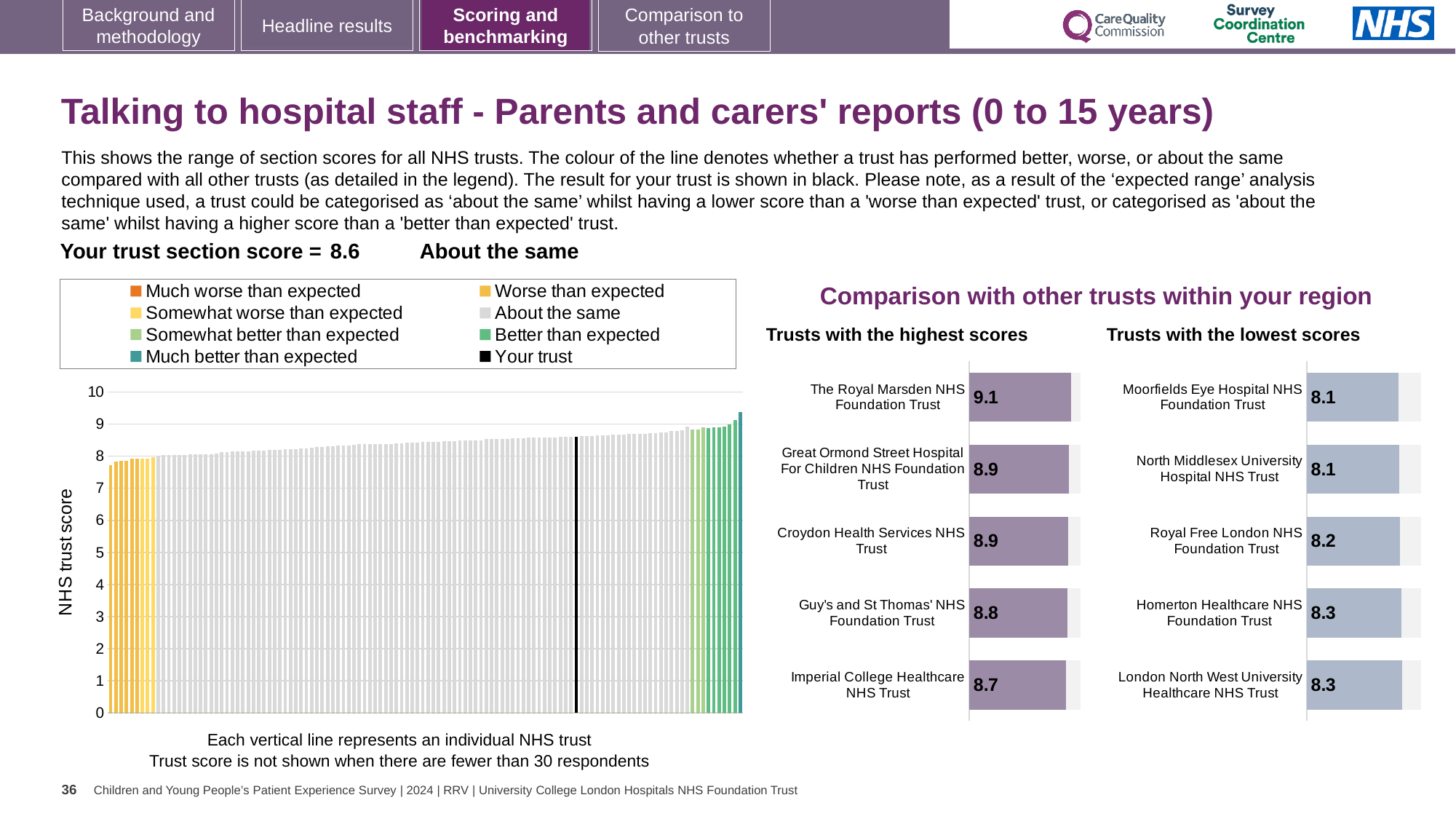
In the 'Trusts with the highest scores' chart, which has the higher score: Croydon Health Services NHS Trust or Guy's and St Thomas' NHS Foundation Trust? Croydon Health Services NHS Trust How many trusts are shown in the 'Trusts with the lowest scores' chart? 5 What kind of chart is the main 'NHS trust score' chart on the left? Bar chart In the 'Trusts with the highest scores' chart, what is the difference between the scores of The Royal Marsden NHS Foundation Trust and Imperial College Healthcare NHS Trust? 0.4 In the 'Trusts with the lowest scores' chart, what is the difference between the scores of Royal Free London NHS Foundation Trust and Moorfields Eye Hospital NHS Foundation Trust? 0.1 In the 'Trusts with the highest scores' chart, which trust has the highest score? The Royal Marsden NHS Foundation Trust In the main 'NHS trust score' chart on the left, what is the section score for your trust? 8.6 In the 'Trusts with the highest scores' chart, what is the score for Imperial College Healthcare NHS Trust? 8.7 How many entries does the legend of the main 'NHS trust score' chart on the left list? 8 In the 'Trusts with the lowest scores' chart, what is the score for Homerton Healthcare NHS Foundation Trust? 8.3 What is the title of the section containing the two charts on the right of the slide? Comparison with other trusts within your region In the 'Trusts with the highest scores' chart, what is the score for The Royal Marsden NHS Foundation Trust? 9.1